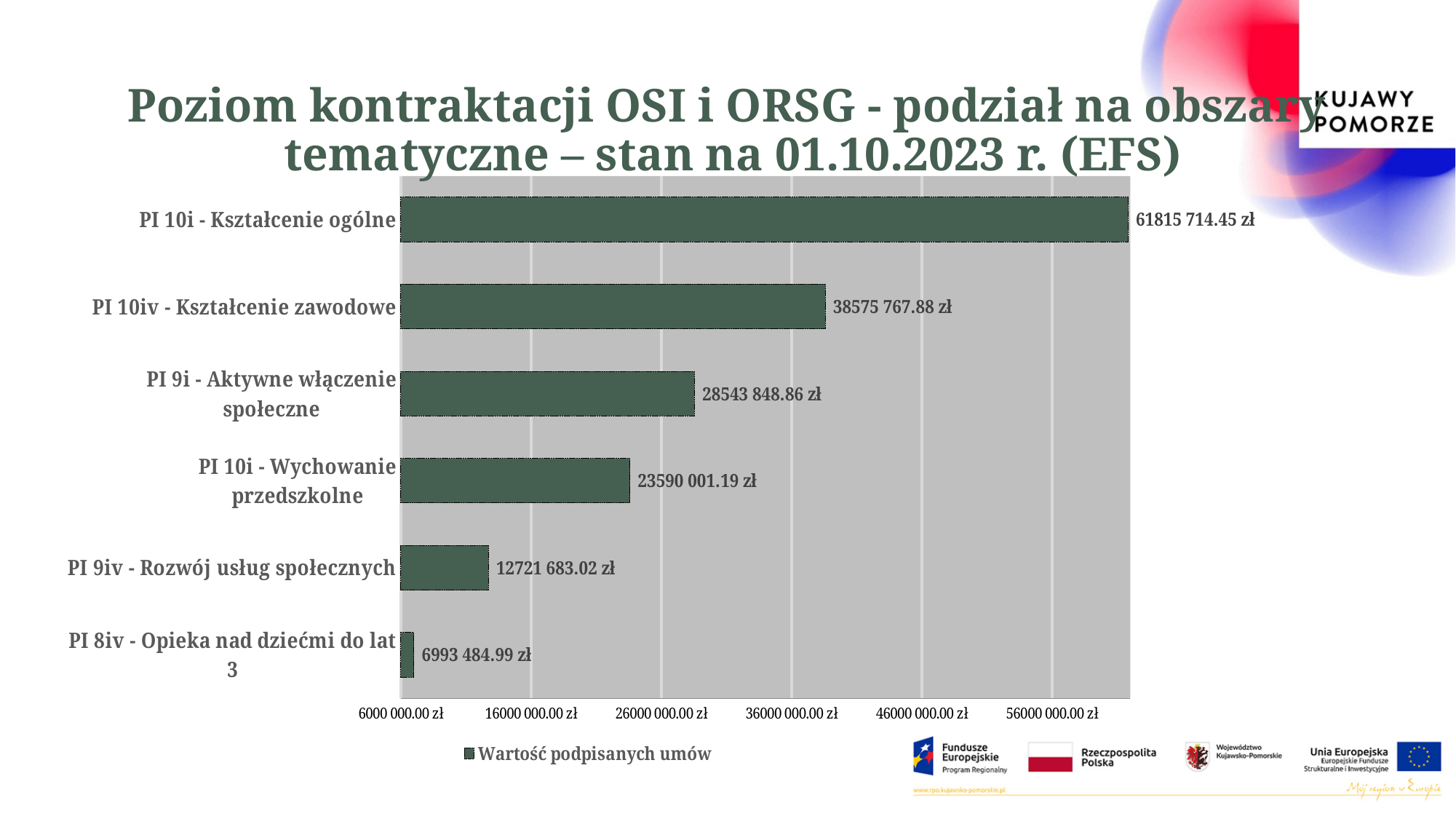
What kind of chart is shown on the slide? bar chart What is the value for PI 9iv - Rozwój usług społecznych? 12721 683.02 zł What is the value for PI 10i - Kształcenie ogólne? 61815 714.45 zł Which is larger: the value for PI 9i - Aktywne włączenie społeczne or PI 10i - Wychowanie przedszkolne? PI 9i - Aktywne włączenie społeczne How many categories are shown in the chart? 6 What is the difference between the values for PI 10i - Kształcenie ogólne and PI 10iv - Kształcenie zawodowe? 23239 946.57 zł What is the value for PI 8iv - Opieka nad dziećmi do lat 3? 6993 484.99 zł Is the value for PI 10iv - Kształcenie zawodowe greater or less than 36000 000.00 zł? greater Which category has the lowest value? PI 8iv - Opieka nad dziećmi do lat 3 Which category has the highest value? PI 10i - Kształcenie ogólne What is the legend entry of the chart? Wartość podpisanych umów What is the value for PI 10i - Wychowanie przedszkolne? 23590 001.19 zł